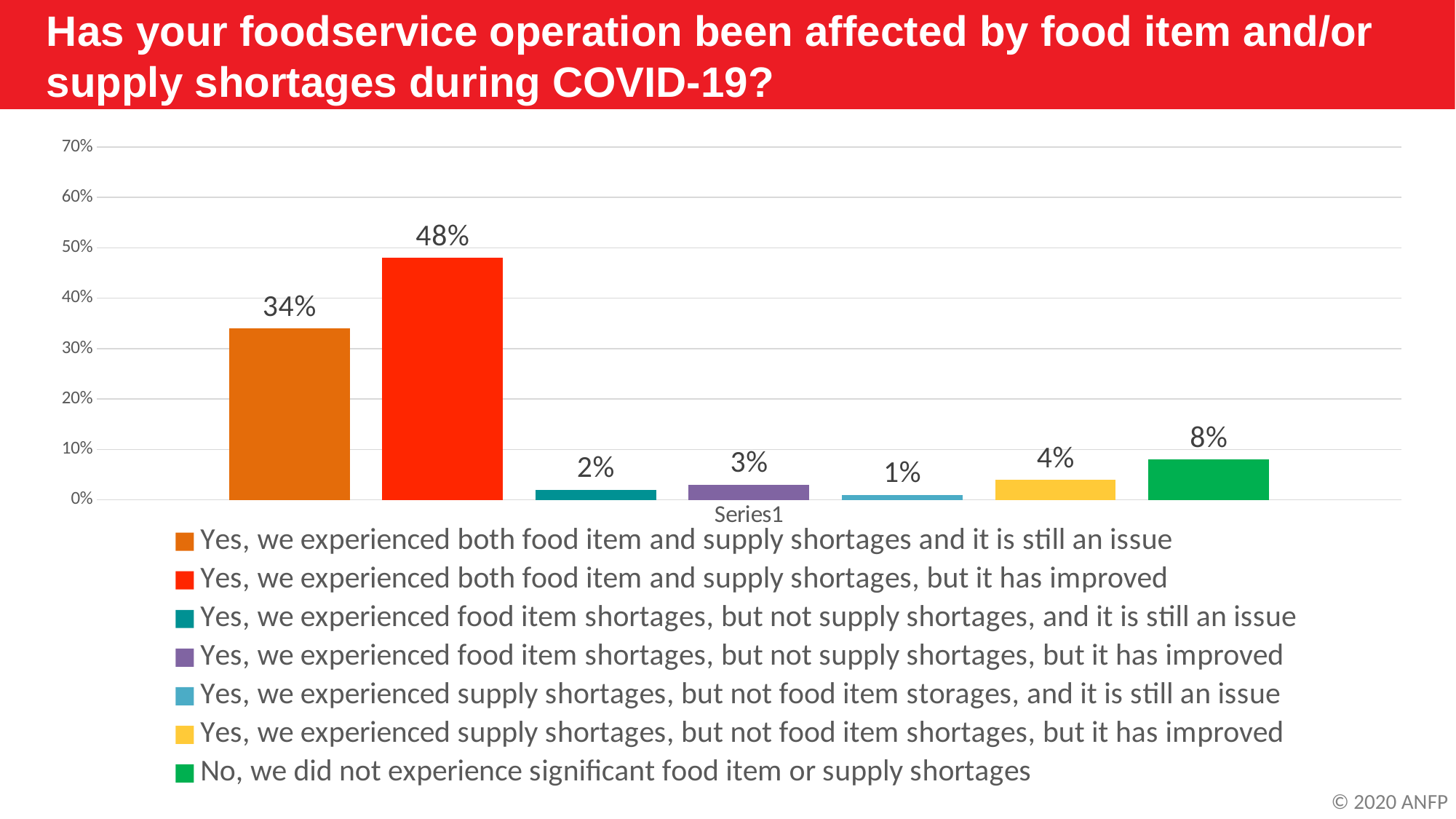
What percentage of respondents said they did not experience significant food item or supply shortages? 8% What is the difference in percentage points between 'both shortages, but it has improved' and 'both shortages and it is still an issue'? 14 Which is larger: the percentage for 'food item shortages, but not supply shortages, but it has improved' or for 'food item shortages, but not supply shortages, and it is still an issue'? Yes, we experienced food item shortages, but not supply shortages, but it has improved Which response option has the lowest percentage? Yes, we experienced supply shortages, but not food item storages, and it is still an issue Which response option has the highest percentage? Yes, we experienced both food item and supply shortages, but it has improved What percentage of respondents said they experienced supply shortages, but not food item shortages, but it has improved? 4% What percentage of respondents said they experienced both food item and supply shortages, but it has improved? 48% How many response options (bars) are shown in the chart? 7 What type of chart is shown on the slide? Bar chart Is the value for 'Yes, we experienced both food item and supply shortages and it is still an issue' greater or less than 30%? greater What colour is the bar for 'No, we did not experience significant food item or supply shortages'? Green What is the combined percentage of the two 'both food item and supply shortages' responses? 82%